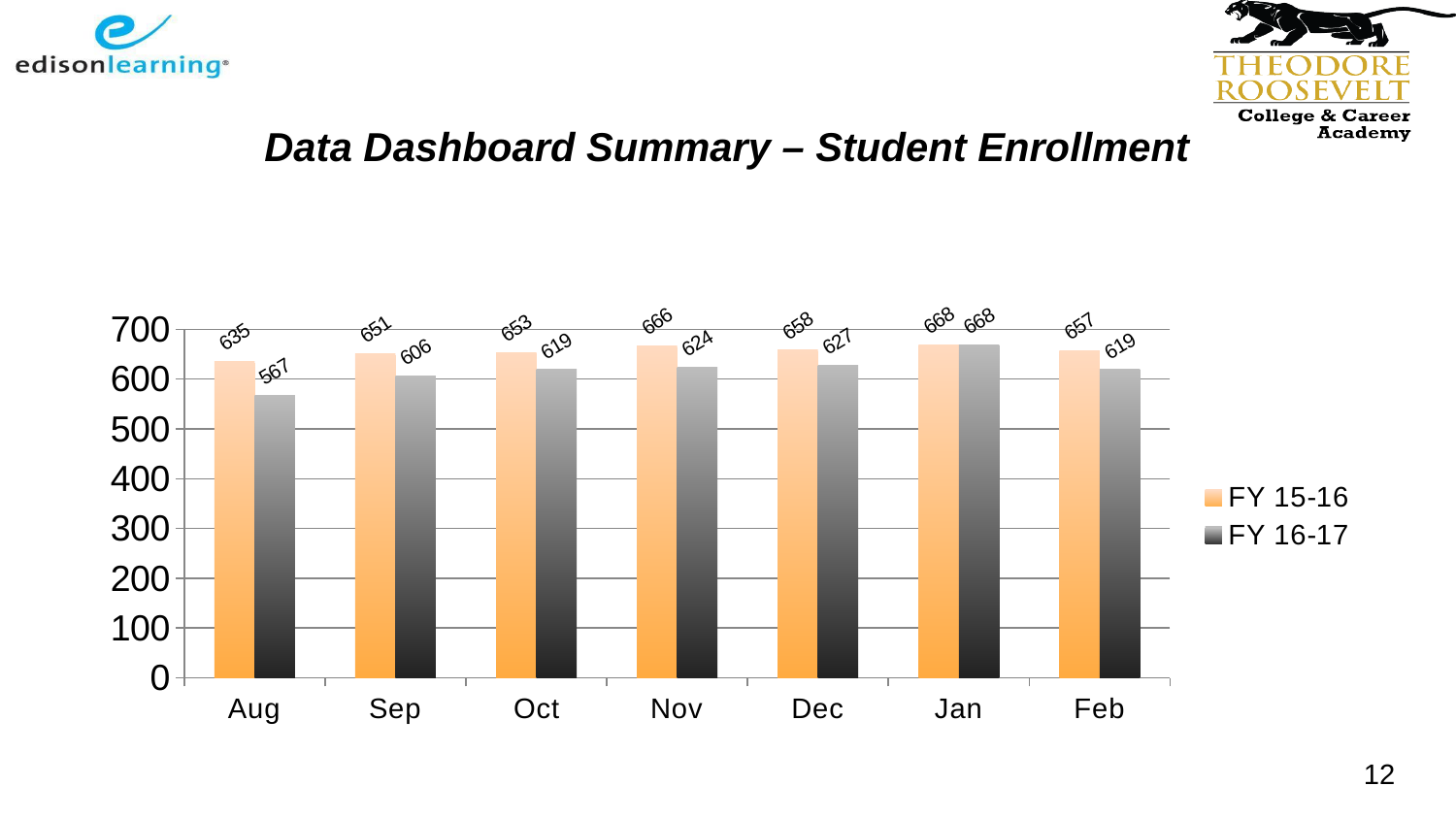
What kind of chart is shown on the slide? bar chart What is the FY 16-17 enrollment value for Dec? 627 What is the difference between the FY 15-16 and FY 16-17 values for Sep? 45 Which month has the highest FY 15-16 value? Jan How many months are shown on the x axis? 7 Is the FY 16-17 value for Aug greater or less than 600? less What is the difference between the FY 15-16 and FY 16-17 values for Aug? 68 Which is larger, the FY 15-16 value for Nov or the FY 16-17 value for Nov? FY 15-16 What is the FY 15-16 enrollment value for Aug? 635 What is the title of the slide containing the chart? Data Dashboard Summary – Student Enrollment Which month has the lowest FY 16-17 value? Aug How many series does the legend list? 2